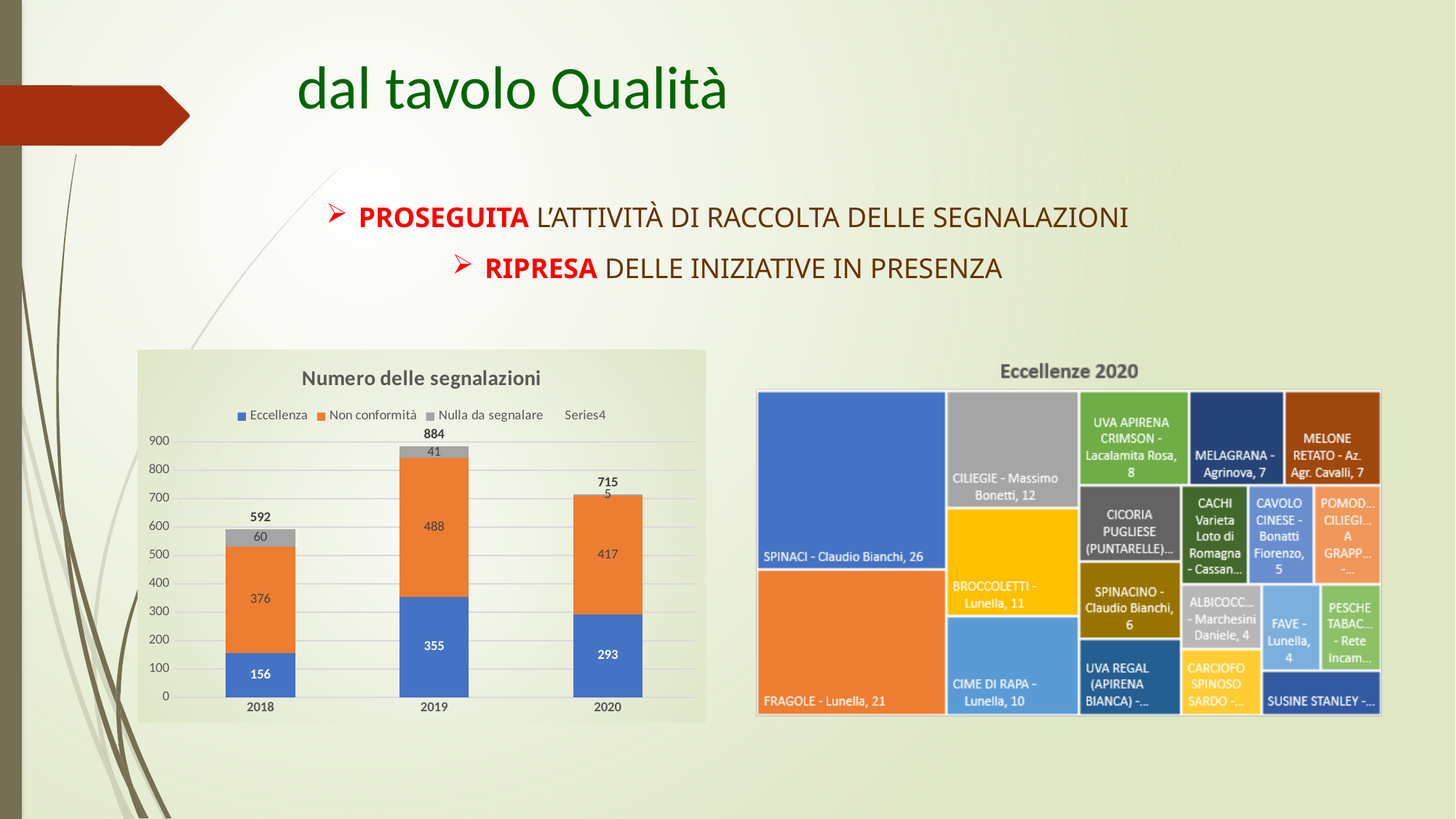
In the 'Eccellenze 2020' chart, which item has the highest value? SPINACI - Claudio Bianchi In the 'Numero delle segnalazioni' chart, what is the Eccellenza value for 2019? 355 In the 'Numero delle segnalazioni' chart, what is the total of the stacked bar for 2019? 884 In the 'Numero delle segnalazioni' chart, what is the Nulla da segnalare value for 2018? 60 In the 'Eccellenze 2020' chart, what is the value for SPINACI - Claudio Bianchi? 26 In the 'Numero delle segnalazioni' chart, what is the Non conformità value for 2020? 417 In the 'Eccellenze 2020' chart, what is the difference between the values for FRAGOLE - Lunella and CILIEGIE - Massimo Bonetti? 9 In the 'Numero delle segnalazioni' chart, what is the difference between the Non conformità values for 2019 and 2018? 112 What kind of chart is 'Numero delle segnalazioni'? Stacked bar chart In the 'Numero delle segnalazioni' chart, how many entries does the legend list? 4 In the 'Numero delle segnalazioni' chart, which is larger: the Eccellenza value for 2020 or for 2018? 2020 In the 'Numero delle segnalazioni' chart, which year has the lowest total number of segnalazioni? 2018